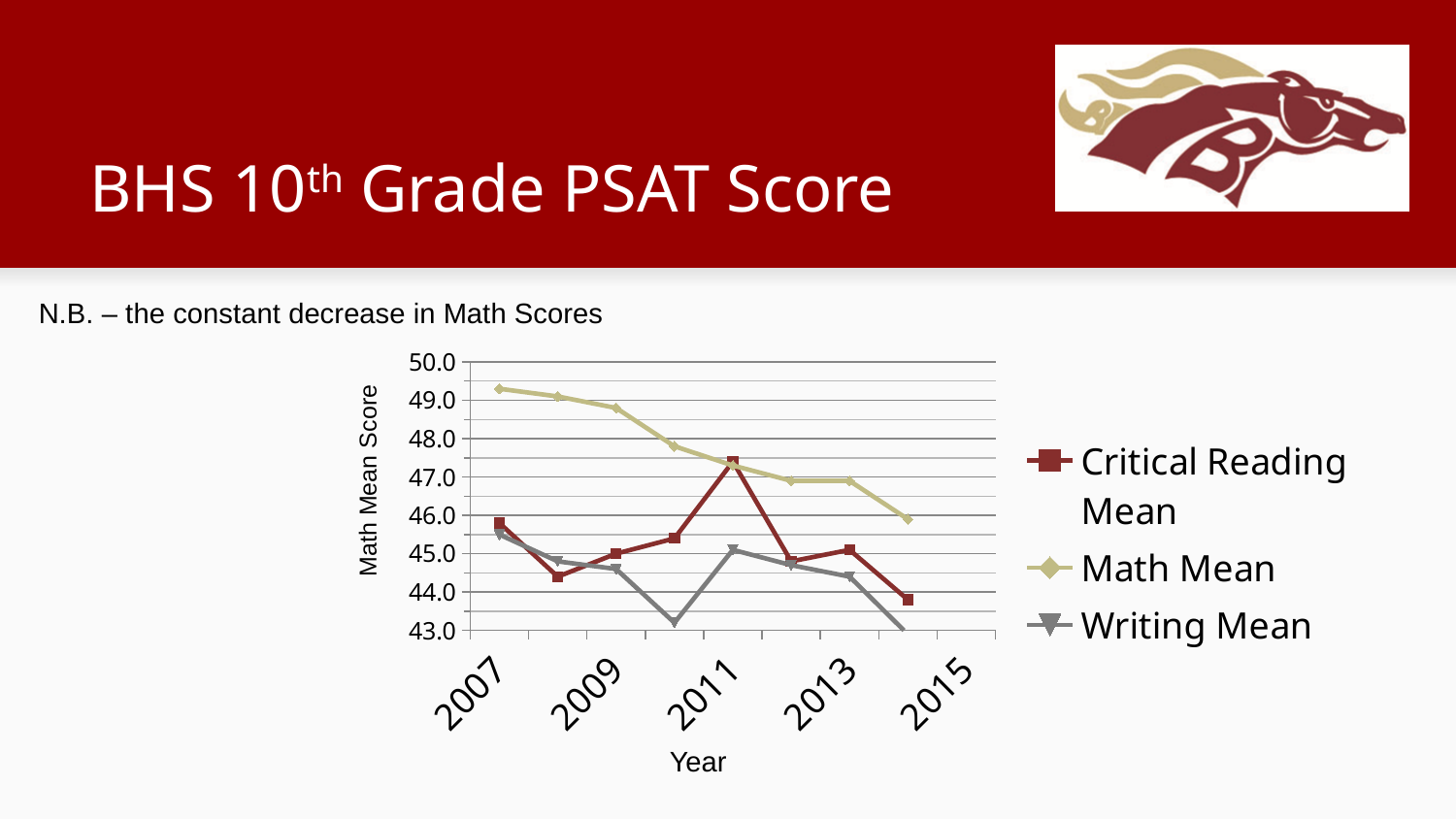
Is the Critical Reading Mean value for 2011 greater or less than 47? greater In which year is the Critical Reading Mean highest? 2011 Is the Math Mean value for 2007 greater or less than 49? greater How many series does the legend list? 3 In 2011, which is larger, the Math Mean or the Writing Mean? Math Mean Is the Math Mean value for 2014 greater or less than 47? less Does the Math Mean series rise or fall from 2007 to 2014? Fall Which series does the legend list between Critical Reading Mean and Writing Mean? Math Mean What kind of chart is shown on the slide? Line chart What is the title of the vertical axis? Math Mean Score